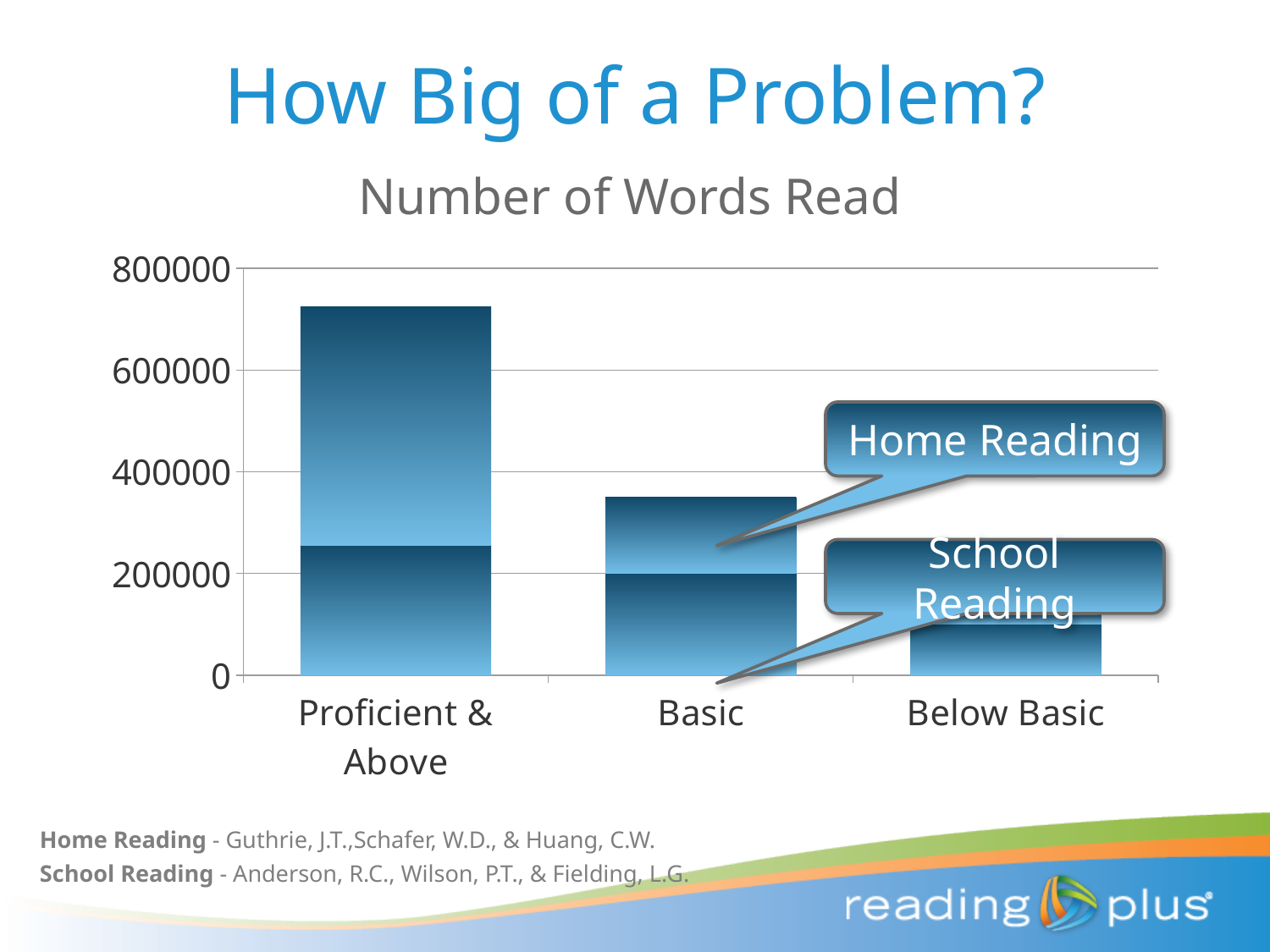
Which category has the lowest total number of words read? Below Basic Is the total value for Proficient & Above greater or less than 600000? greater Which category has the highest total number of words read? Proficient & Above What kind of chart is shown on the slide? stacked bar chart What is the title of the chart? Number of Words Read Is the total value for Below Basic greater or less than 200000? less How many series does the chart show? 2 How many categories are shown on the x axis of the chart? 3 Which series is shown as the top segment of each stacked bar? Home Reading Which has a larger total number of words read, Basic or Below Basic? Basic Do the total values rise or fall moving from Proficient & Above to Below Basic along the x axis? fall Is the total value for Basic greater or less than 400000? less